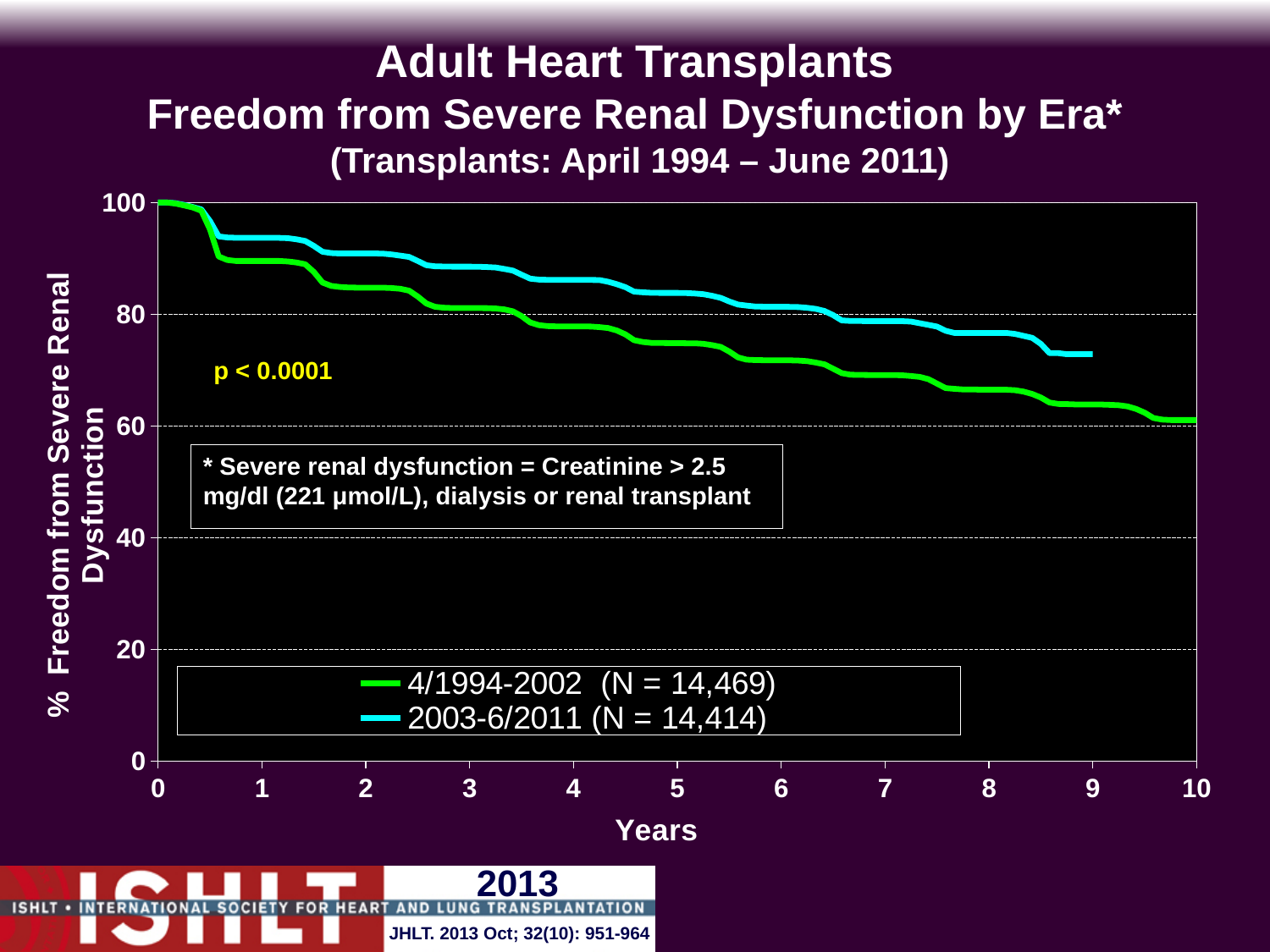
What kind of chart is shown on the slide? line chart What is the N shown in the legend for the 4/1994-2002 series? 14,469 Is the value for the 4/1994-2002 series at 5 years greater or less than 80? less Which series stays higher across the whole chart, 4/1994-2002 or 2003-6/2011? 2003-6/2011 Is the value for the 2003-6/2011 series at 9 years greater or less than 60? greater Which series has the higher freedom from severe renal dysfunction at 5 years, 4/1994-2002 or 2003-6/2011? 2003-6/2011 Is the value for the 2003-6/2011 series at 8 years greater or less than 80? less What p-value is printed on the chart? p < 0.0001 Do the values for the 4/1994-2002 series rise or fall as years increase? fall How many series does the legend list? 2